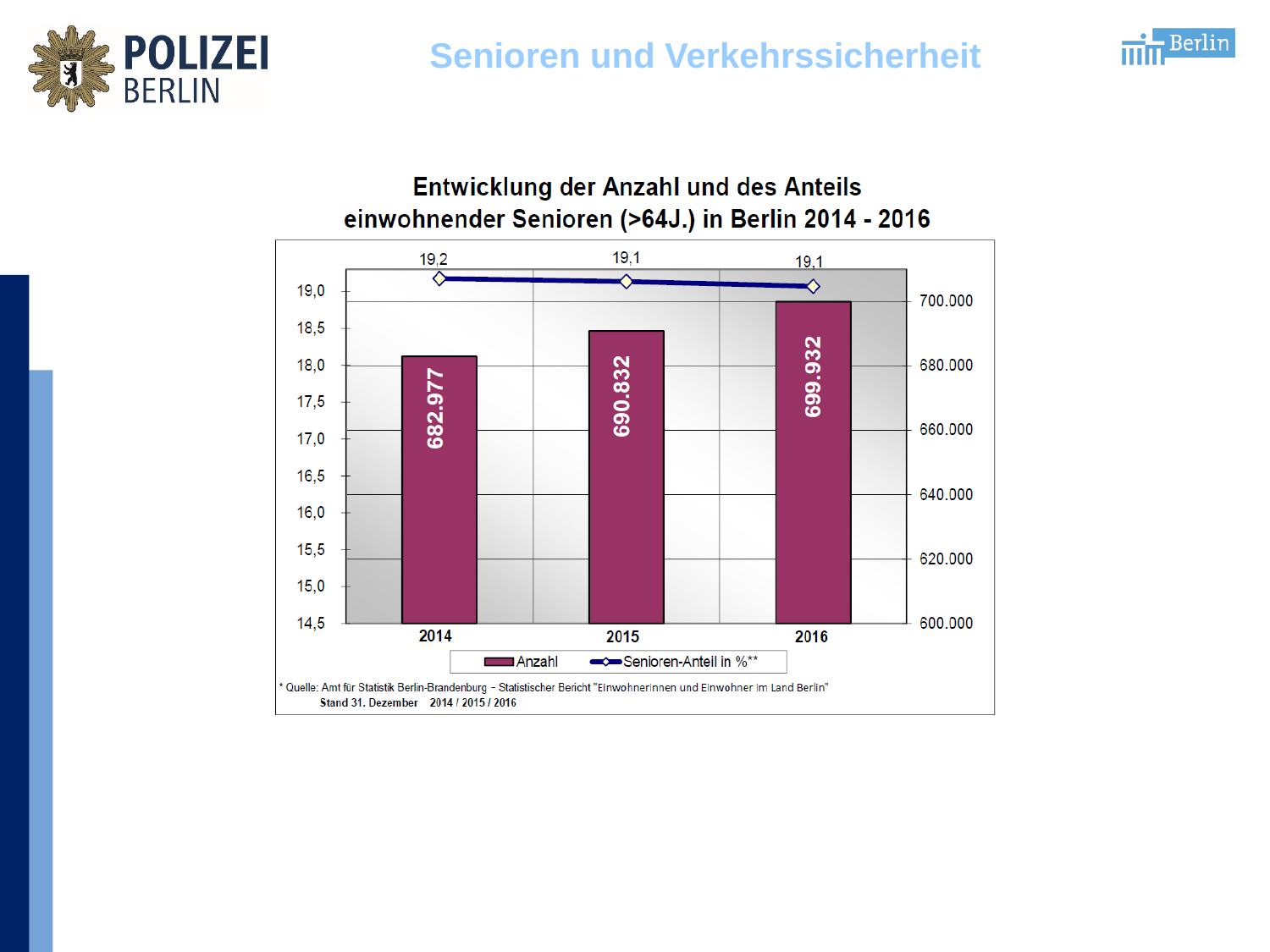
Which is larger, the Anzahl for 2015 or for 2016? 2016 What is the Senioren-Anteil in % for 2016? 19,1 How many years are shown on the x axis? 3 What is the Senioren-Anteil in % for 2014? 19,2 How many series does the legend list? 2 Which year has the lowest Anzahl? 2014 Does the Anzahl rise or fall from 2014 to 2016? rise Which year has the highest Anzahl? 2016 What is the Anzahl value for 2016? 699.932 What is the difference in Anzahl between 2015 and 2014? 7.855 What is the Anzahl value for 2014? 682.977 What is the difference in Anzahl between 2016 and 2014? 16.955